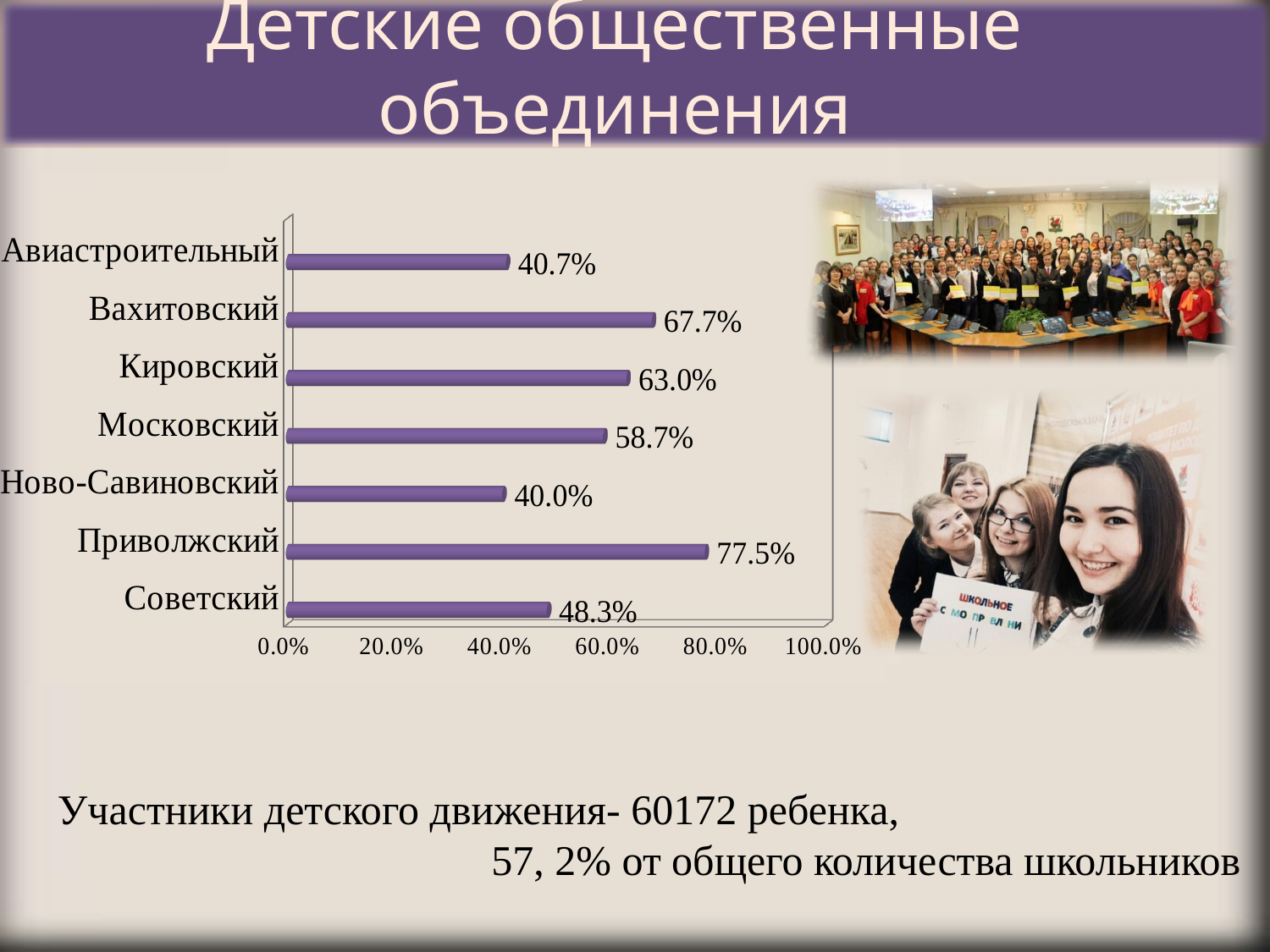
What is the value for Приволжский? 77.5% What kind of chart is shown on the slide? bar chart Which category has the lowest value? Ново-Савиновский What is the value for Вахитовский? 67.7% What is the value for Советский? 48.3% Which is larger, the value for Кировский or the value for Советский? Кировский Is the value for Советский greater or less than 60.0%? less Which category has the highest value? Приволжский How many categories are shown in the chart? 7 What is the difference between the values for Приволжский and Ново-Савиновский? 37.5 percentage points What is the difference between the values for Вахитовский and Кировский? 4.7 percentage points What is the value for Московский? 58.7%